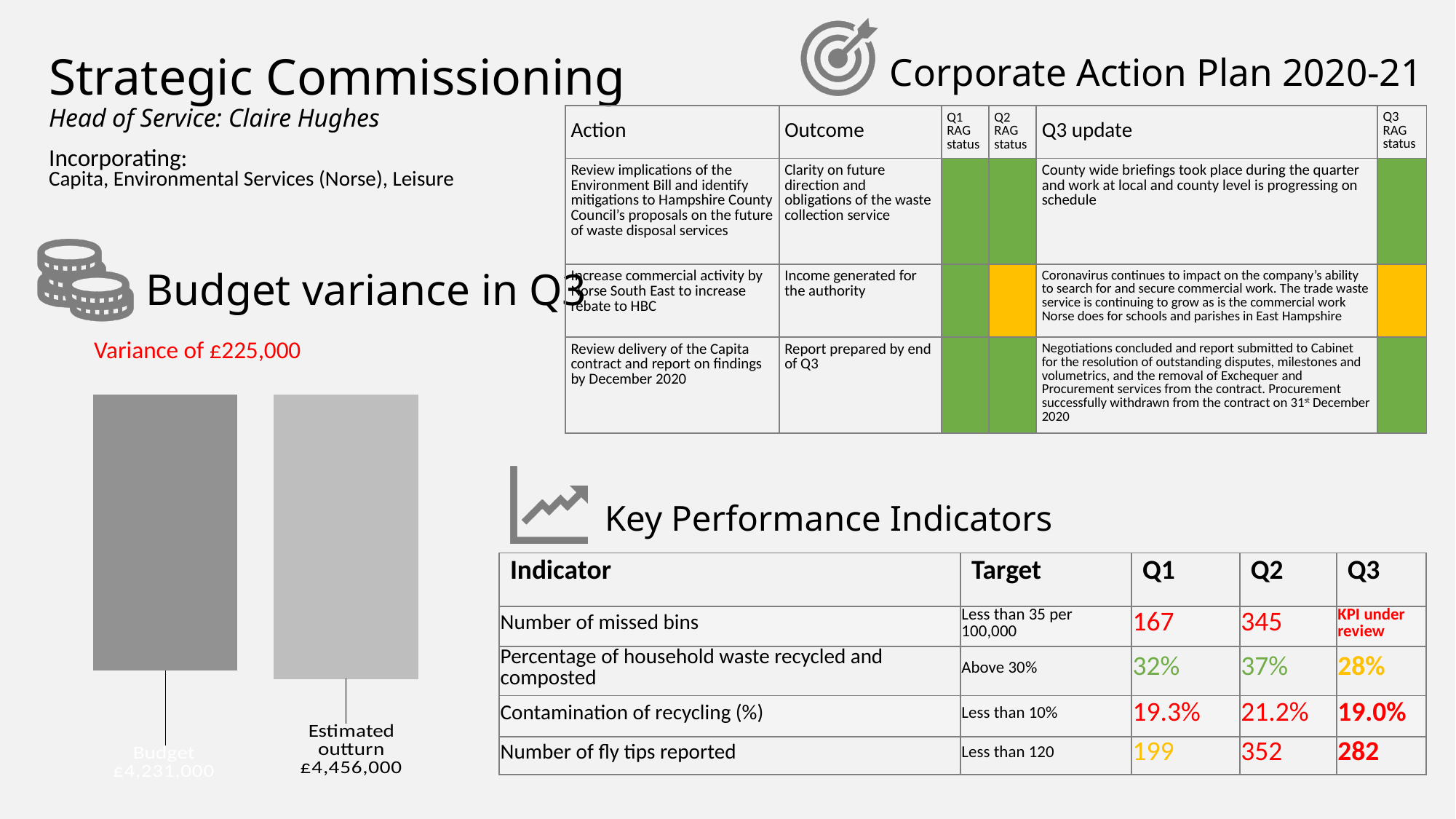
In the 'Budget variance in Q3' chart, what is the value of the Budget bar? £4,231,000 In the 'Budget variance in Q3' chart, what is the difference between the Estimated outturn and the Budget? £225,000 What kind of chart is shown under the heading 'Budget variance in Q3'? bar chart How many bars does the 'Budget variance in Q3' chart show? 2 What variance amount is stated in red text above the 'Budget variance in Q3' chart? Variance of £225,000 What is the title of the chart on the left of the slide? Budget variance in Q3 In the 'Budget variance in Q3' chart, what is the value of the Estimated outturn bar? £4,456,000 In the 'Budget variance in Q3' chart, which is larger according to the data labels: Budget or Estimated outturn? Estimated outturn